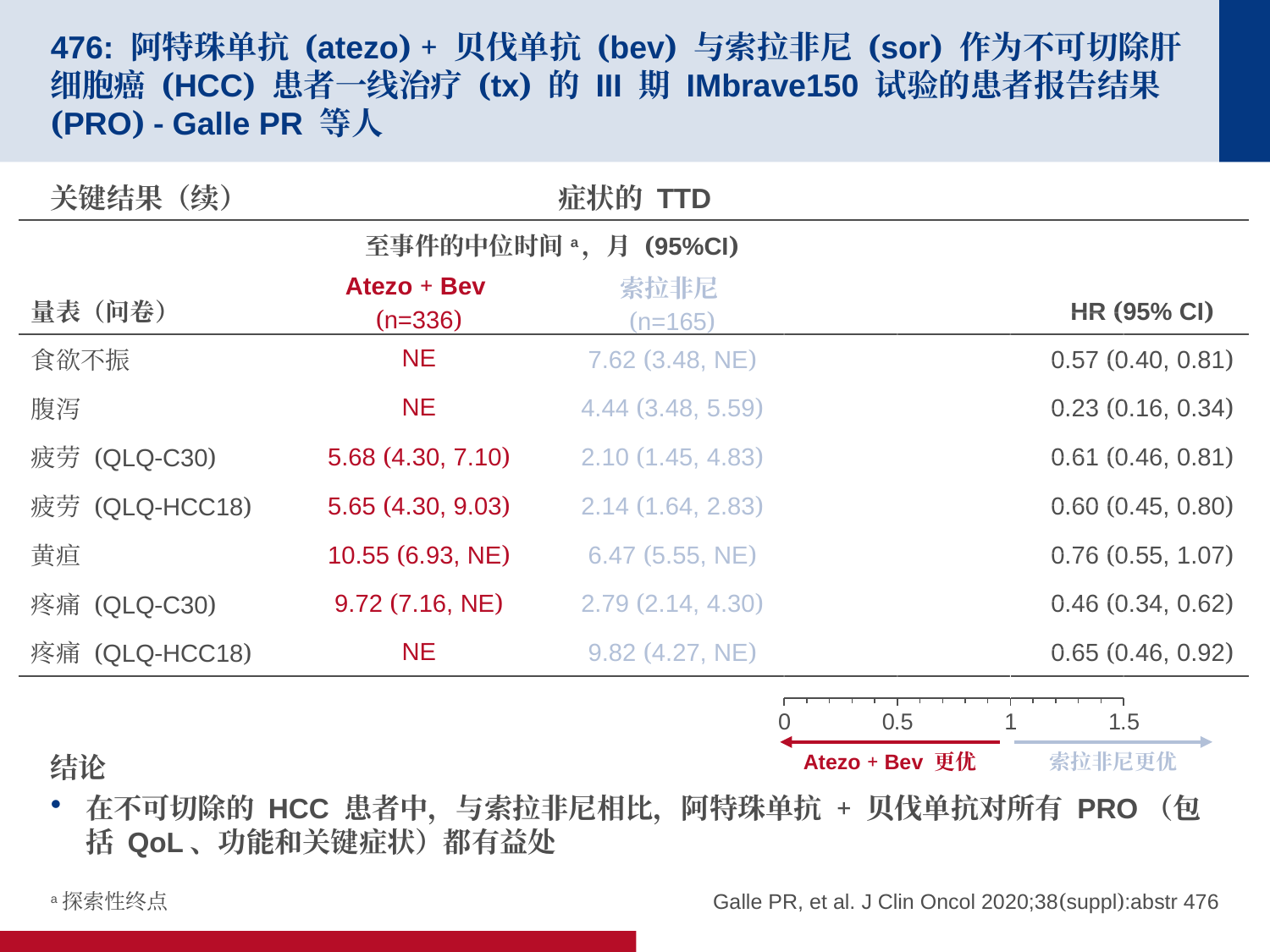
Which treatment does the left side of the hazard ratio axis favour? Atezo + Bev What is the HR (95% CI) for 腹泻 in the forest plot table? 0.23 (0.16, 0.34) Is the hazard ratio for 腹泻 greater or less than 0.5? less Is the hazard ratio for 黄疸 greater or less than 0.5? greater Which scale has the lowest hazard ratio? 腹泻 What is the median time to event for 疲劳 (QLQ-C30) in the Atezo + Bev arm? 5.68 (4.30, 7.10) What is the HR (95% CI) for 疼痛 (QLQ-C30)? 0.46 (0.34, 0.62) How many scales (量表) are listed in the forest plot table? 7 Which has the larger hazard ratio, 疲劳 (QLQ-C30) or 疼痛 (QLQ-C30)? 疲劳 (QLQ-C30) What is the HR (95% CI) for 黄疸? 0.76 (0.55, 1.07) What is the median time to event for 食欲不振 in the 索拉非尼 arm? 7.62 (3.48, NE) Which scale has the highest hazard ratio? 黄疸